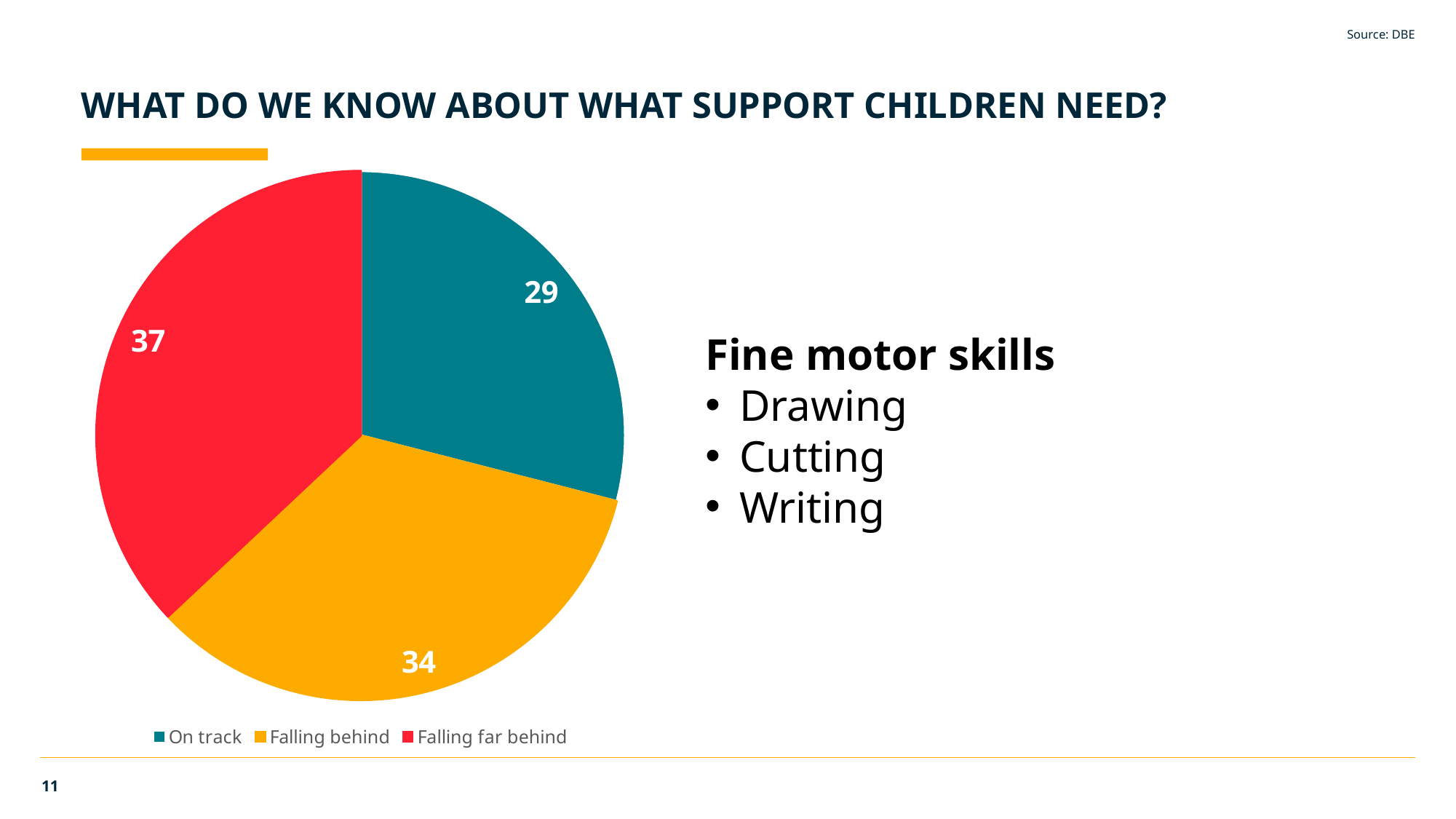
What is the difference between the Falling far behind and On track values? 8 What kind of chart is shown on the slide? Pie chart What is the difference between the Falling behind and On track values? 5 How many slices does the pie chart have? 3 How many entries does the legend list? 3 What colour is the Falling far behind slice? Red What is the value for the Falling behind slice? 34 Which category has the smallest slice? On track Which category has the largest slice? Falling far behind What is the value for the On track slice? 29 Which is larger, Falling behind or On track? Falling behind What is the value for the Falling far behind slice? 37